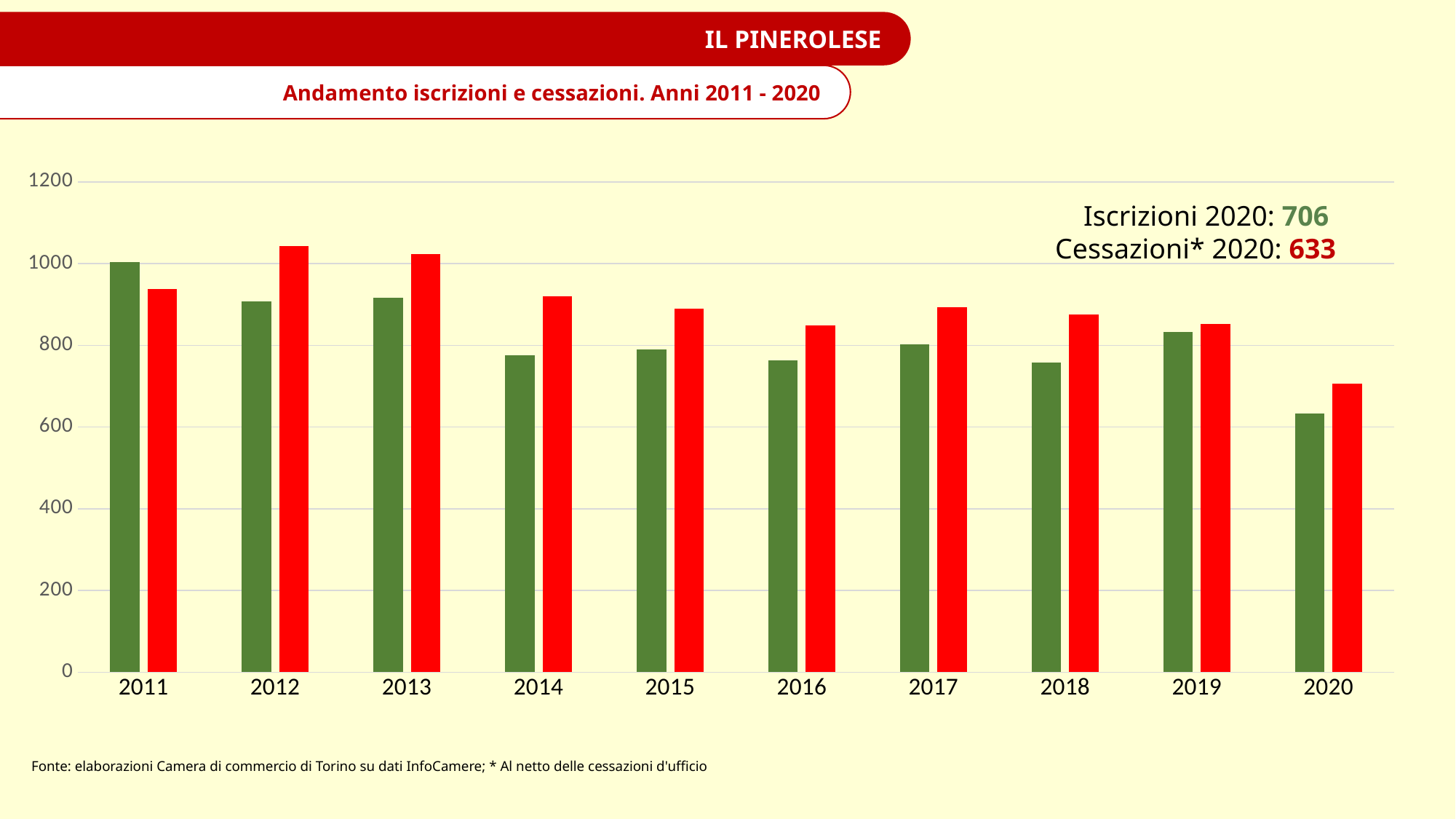
What is the value of Iscrizioni 2020 printed on the slide? 706 What kind of chart is shown on the slide? bar chart What is the value of Cessazioni* 2020 printed on the slide? 633 What is the difference between the printed Iscrizioni 2020 and Cessazioni* 2020 values? 73 Is the value of the green bar for 2014 greater or less than 800? less How many years are shown on the x axis of the chart? 10 Is the value of the red bar for 2012 greater or less than 1000? greater In which year is the red bar the tallest? 2012 How many bars are plotted for each year in the chart? 2 In which year is the green bar the shortest? 2020 What is the title of the chart? Andamento iscrizioni e cessazioni. Anni 2011 - 2020 According to the printed values for 2020, which is larger: Iscrizioni or Cessazioni? Iscrizioni